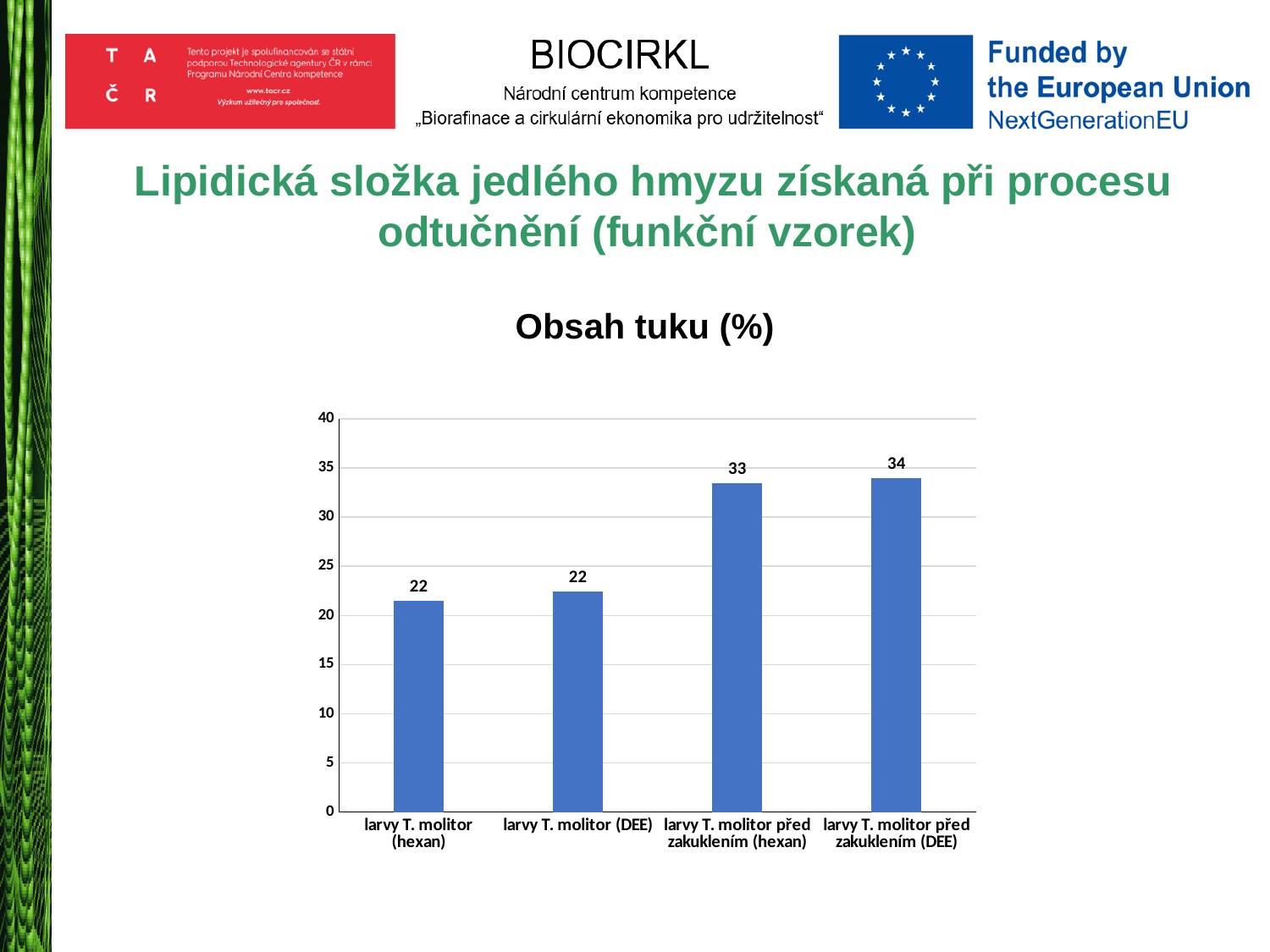
What is the value for larvy T. molitor před zakuklením (DEE)? 34 What is the difference between larvy T. molitor před zakuklením (DEE) and larvy T. molitor (DEE)? 12 What kind of chart is shown on the slide? bar chart What is the title of the chart? Obsah tuku (%) What is the difference between larvy T. molitor před zakuklením (hexan) and larvy T. molitor (hexan)? 11 Is the value for larvy T. molitor (hexan) greater or less than 25? less Is the value for larvy T. molitor před zakuklením (hexan) greater or less than 30? greater Which is larger: larvy T. molitor před zakuklením (hexan) or larvy T. molitor před zakuklením (DEE)? larvy T. molitor před zakuklením (DEE) What is the value for larvy T. molitor (hexan)? 22 What is the value for larvy T. molitor před zakuklením (hexan)? 33 Which category has the highest value? larvy T. molitor před zakuklením (DEE) How many categories are shown in the chart? 4